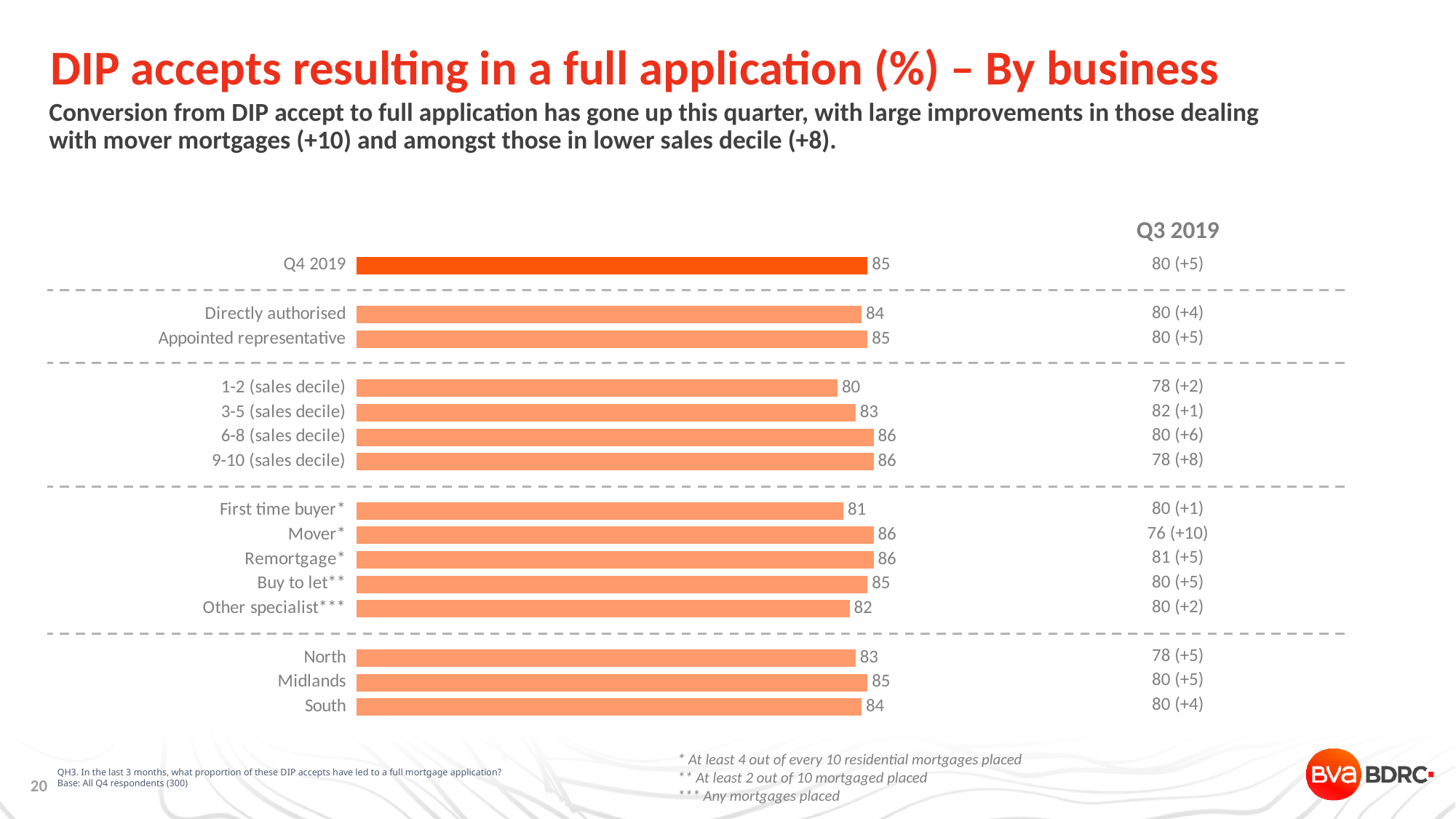
What is the difference between the values for 9-10 (sales decile) and 1-2 (sales decile)? 6 What is the value for 1-2 (sales decile)? 80 What Q3 2019 figure is shown next to Mover? 76 (+10) How many bars are plotted in the chart? 16 What is the value for Q4 2019 overall? 85 What is the highest value shown on any bar? 86 Which category has the lowest value? 1-2 (sales decile) Which is larger, the value for North or the value for Midlands? Midlands What is the value for Other specialist? 82 What is the difference between the values for Mover and First time buyer? 5 What is the value for Mover? 86 What kind of chart is shown on the slide? Bar chart